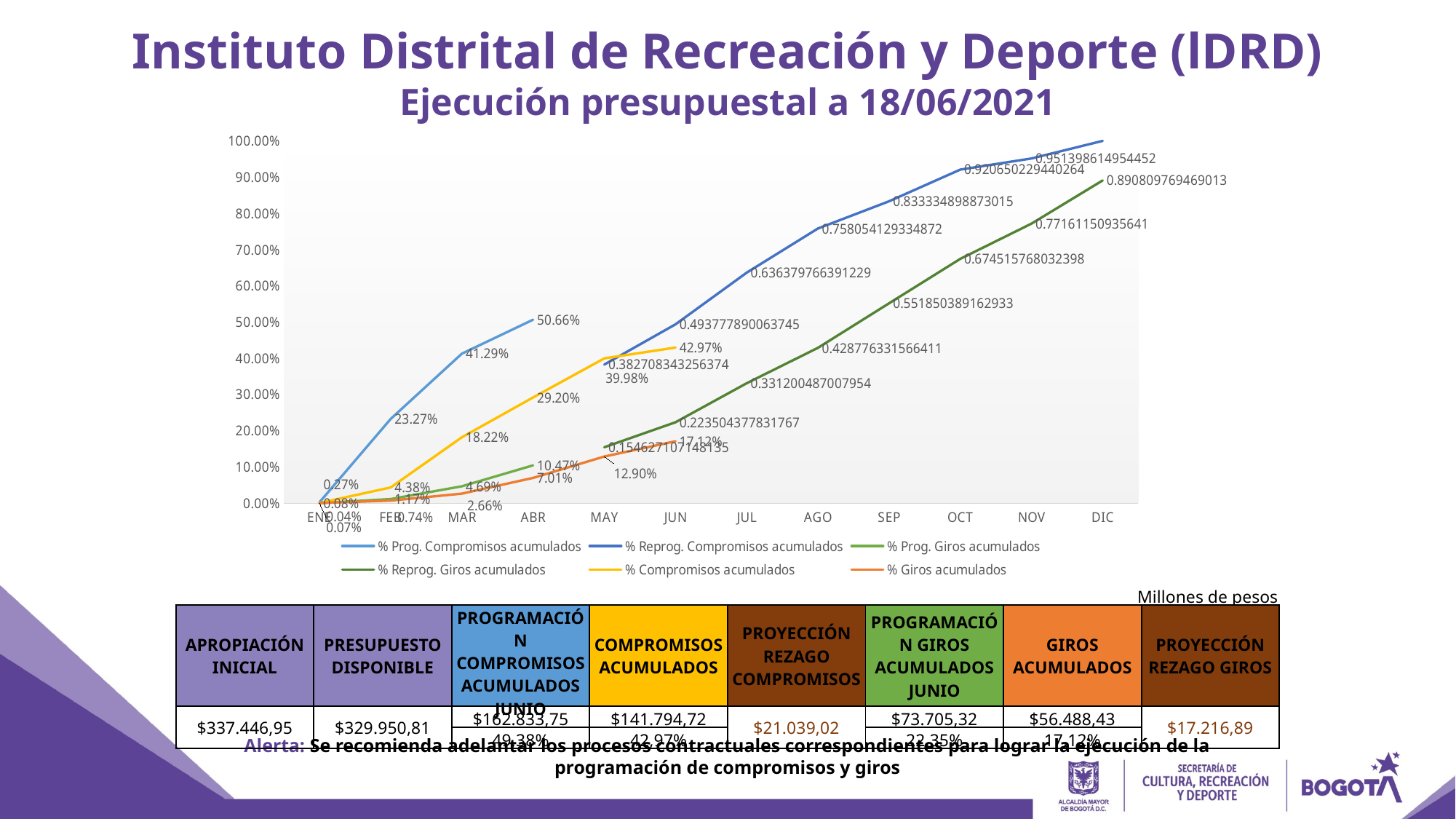
Does % Reprog. Giros acumulados rise or fall from MAY to DIC? rise What is the value of % Prog. Compromisos acumulados in ABR? 50.66% Which is larger in MAR: % Prog. Compromisos acumulados or % Compromisos acumulados? % Prog. Compromisos acumulados What is the difference between % Compromisos acumulados and % Giros acumulados in JUN? 25.85% What is the value of % Giros acumulados in JUN? 17.12% How many series does the chart legend list? 6 Is the value of % Reprog. Compromisos acumulados in DIC greater or less than 90.00%? greater What is the value of % Compromisos acumulados in JUN? 42.97% How many months are shown on the x axis of the chart? 12 What is the value of % Reprog. Giros acumulados in DIC? 0.890809769469013 What is the value of % Reprog. Compromisos acumulados in NOV? 0.951398614954452 What type of chart is shown on the slide? line chart